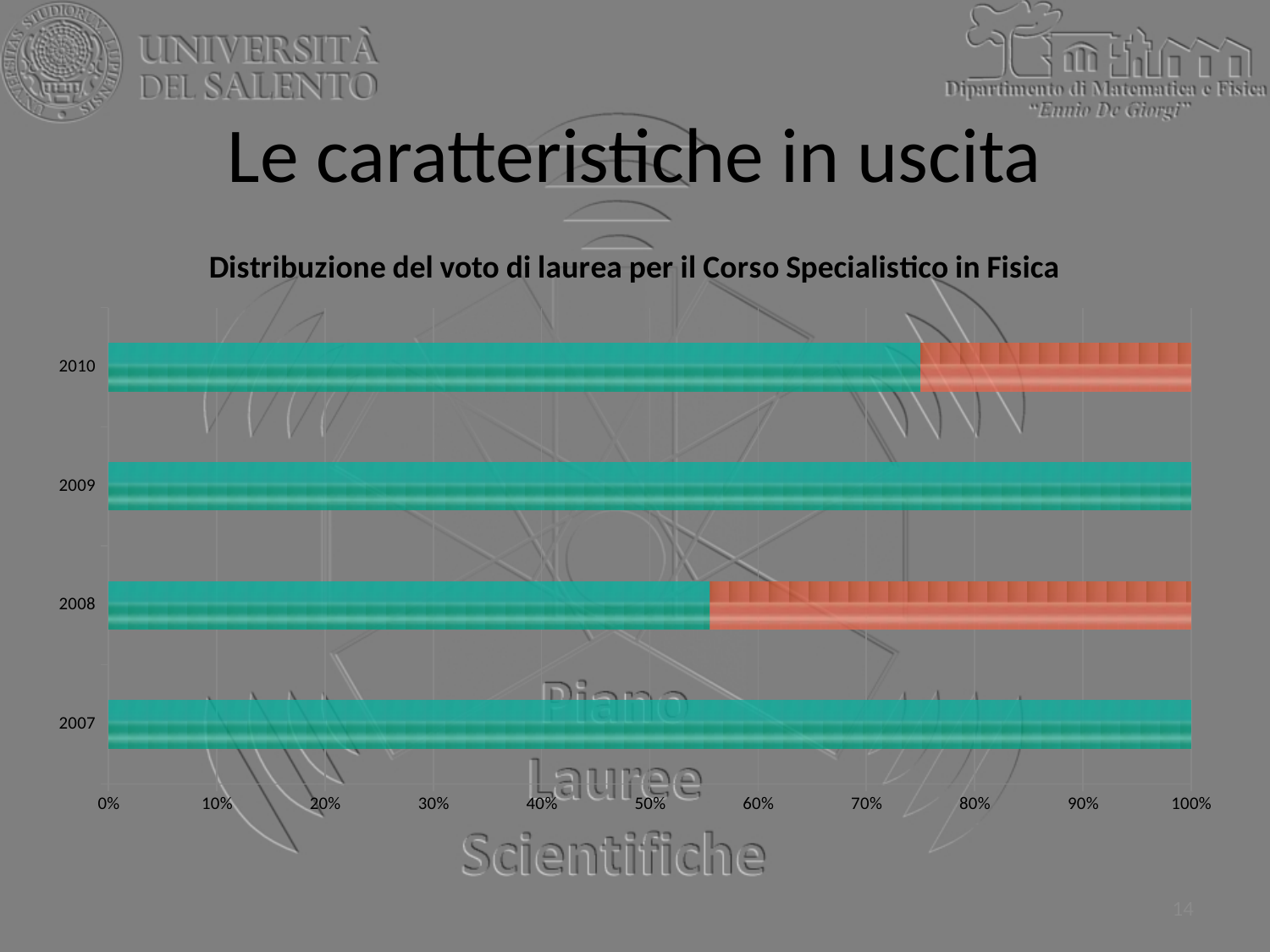
Is the orange segment for 2010 greater or less than 30%? less Which years are shown on the vertical axis of the chart? 2007, 2008, 2009, 2010 Which year has the largest orange segment? 2008 What is the value of the teal segment for 2009? 100% What is the value of the teal segment for 2007? 100% How many years (categories) are shown on the chart? 4 What kind of chart is shown on the slide? Stacked horizontal bar chart Is the teal segment for 2008 greater or less than 60%? less Is the teal segment for 2010 greater or less than 70%? greater Is the teal segment for 2010 larger or smaller than the teal segment for 2008? larger What is the title of the chart? Distribuzione del voto di laurea per il Corso Specialistico in Fisica Which year has the smallest teal segment? 2008